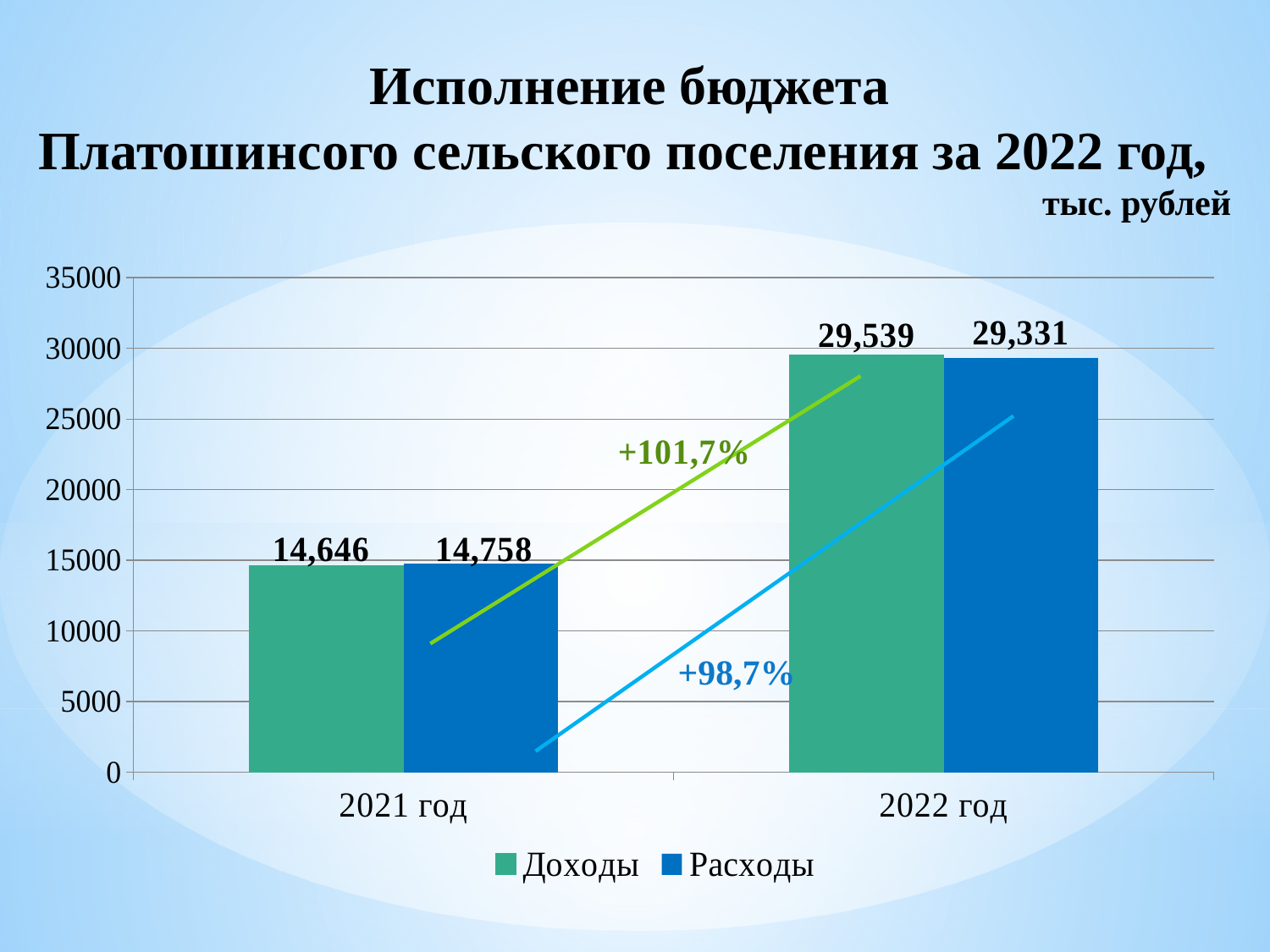
Which year has the lowest value for Расходы? 2021 год In 2021 год, which is larger: Доходы or Расходы? Расходы What is the value for Доходы in 2021 год? 14,646 Which year has the highest value for Доходы? 2022 год What kind of chart is shown on the slide? Bar chart What is the difference between Доходы and Расходы in 2022 год? 208 How many series does the legend list? 2 What is the value for Доходы in 2022 год? 29,539 What is the value for Расходы in 2021 год? 14,758 What is the value for Расходы in 2022 год? 29,331 What percentage change is annotated for Расходы between 2021 год and 2022 год? +98,7% What is the difference between Доходы in 2022 год and Доходы in 2021 год? 14,893